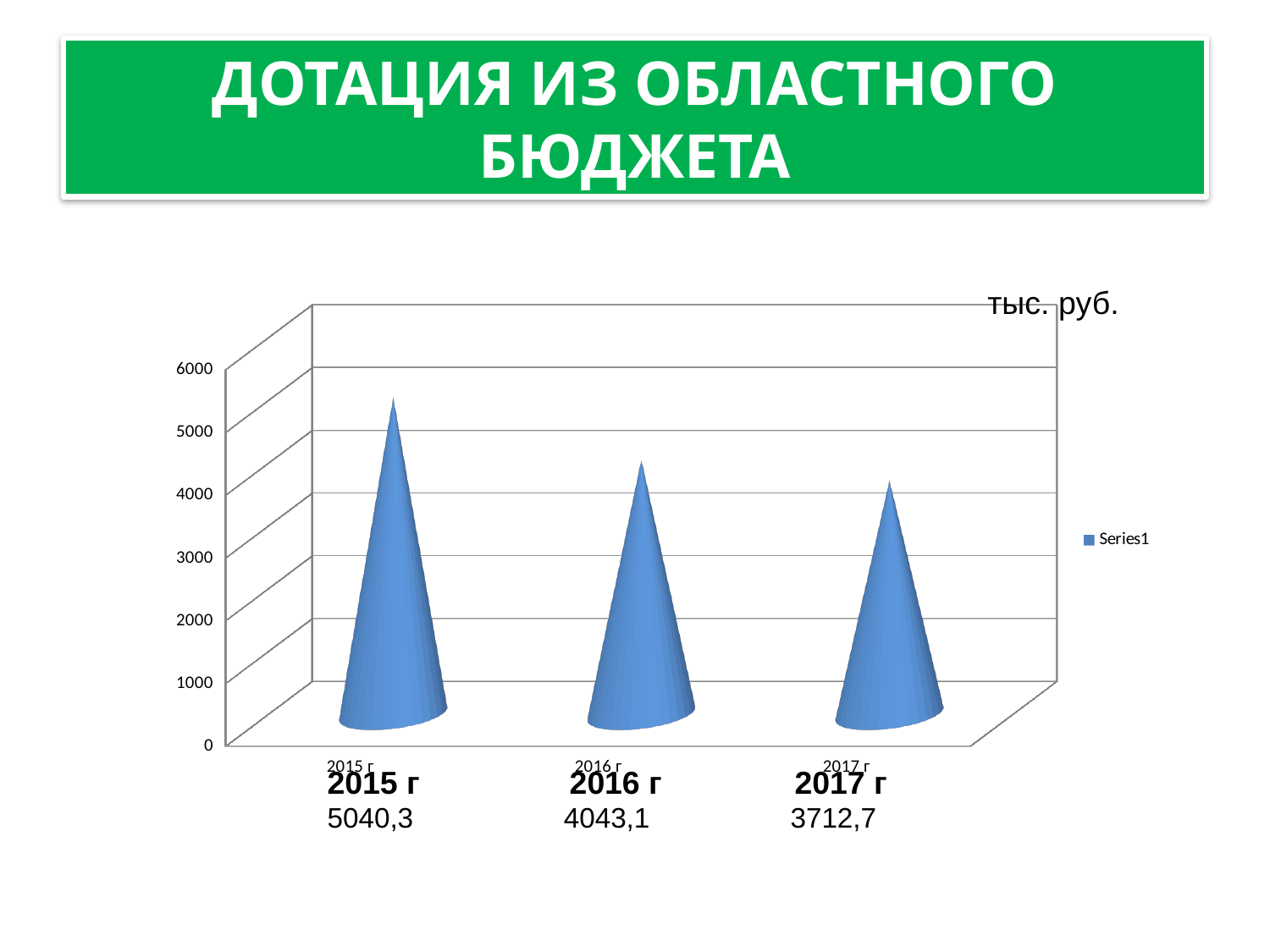
What is the difference between the values for 2016 г and 2017 г? 330,4 Which year has the lowest value? 2017 г What unit is indicated for the chart values? тыс. руб. What is the value for 2015 г? 5040,3 What is the value for 2016 г? 4043,1 What is the value for 2017 г? 3712,7 Do the values rise or fall from 2015 г to 2017 г? fall Which is larger, the value for 2016 г or the value for 2017 г? 2016 г How many categories are shown on the chart? 3 Which year has the highest value? 2015 г Is the value for 2015 г greater or less than 5000? greater What is the difference between the values for 2015 г and 2016 г? 997,2